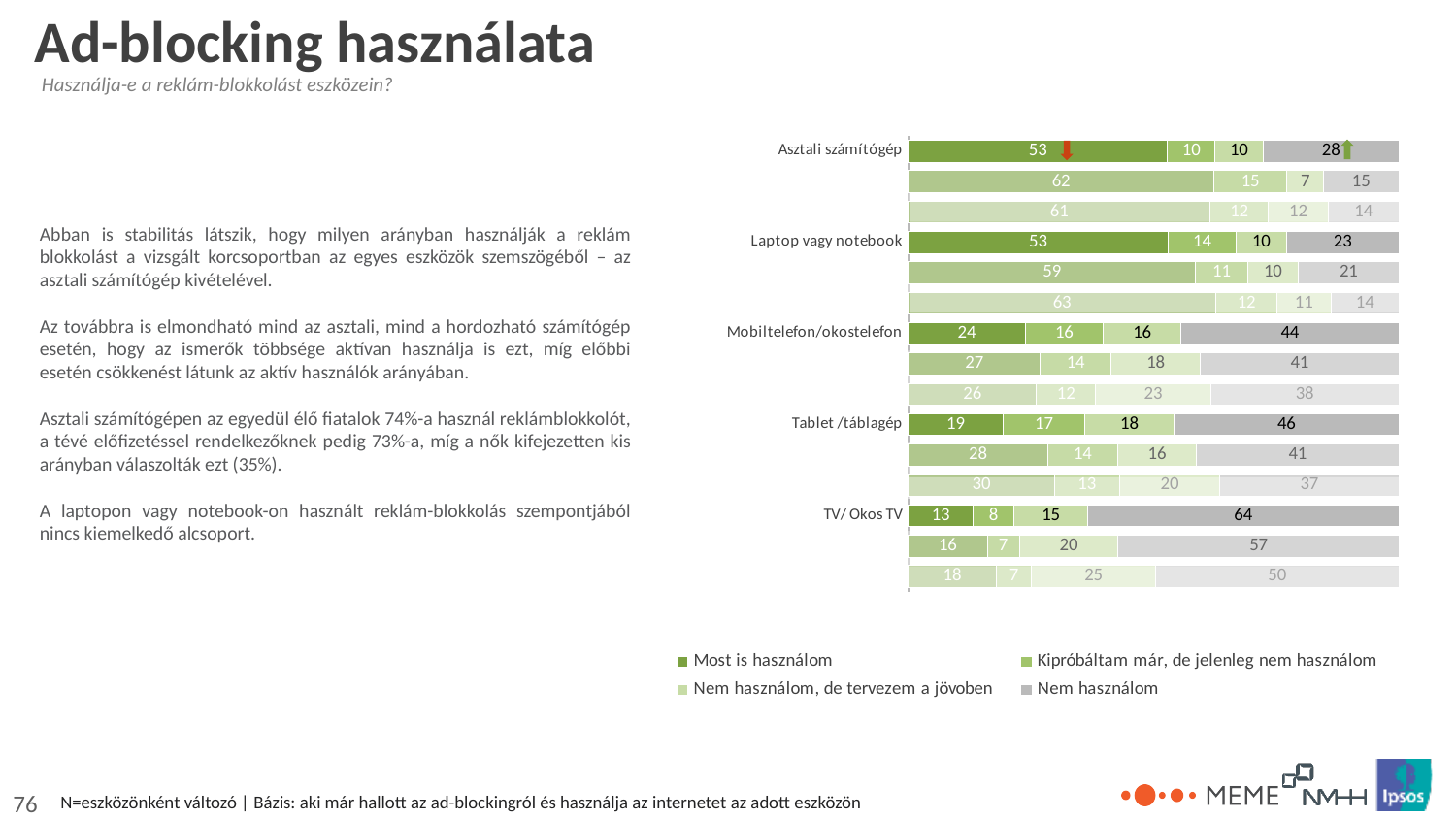
Among the top (darkest) bars, which device category has the lowest 'Most is használom' value? TV/ Okos TV Among the top (darkest) bars, which device category has the highest 'Nem használom' value? TV/ Okos TV What kind of chart is shown on the slide? stacked bar chart In the top (darkest) bar for Asztali számítógép, what is the value for 'Most is használom'? 53 What is the total of the top (darkest) stacked bar for Laptop vagy notebook? 100 How many series does the chart legend list? 4 In the top (darkest) bar for TV/ Okos TV, what is the value for 'Nem használom'? 64 In the top (darkest) bars, what is the difference between the 'Most is használom' value for Asztali számítógép and for Mobiltelefon/okostelefon? 29 In the top (darkest) bars, which is larger: the 'Nem használom' value for Tablet /táblagép or for Mobiltelefon/okostelefon? Tablet /táblagép How many device categories are labelled on the chart's vertical axis? 5 In the top (darkest) bar for Tablet /táblagép, what is the value for 'Kipróbáltam már, de jelenleg nem használom'? 17 Which legend entry is shown with the darkest green colour? Most is használom